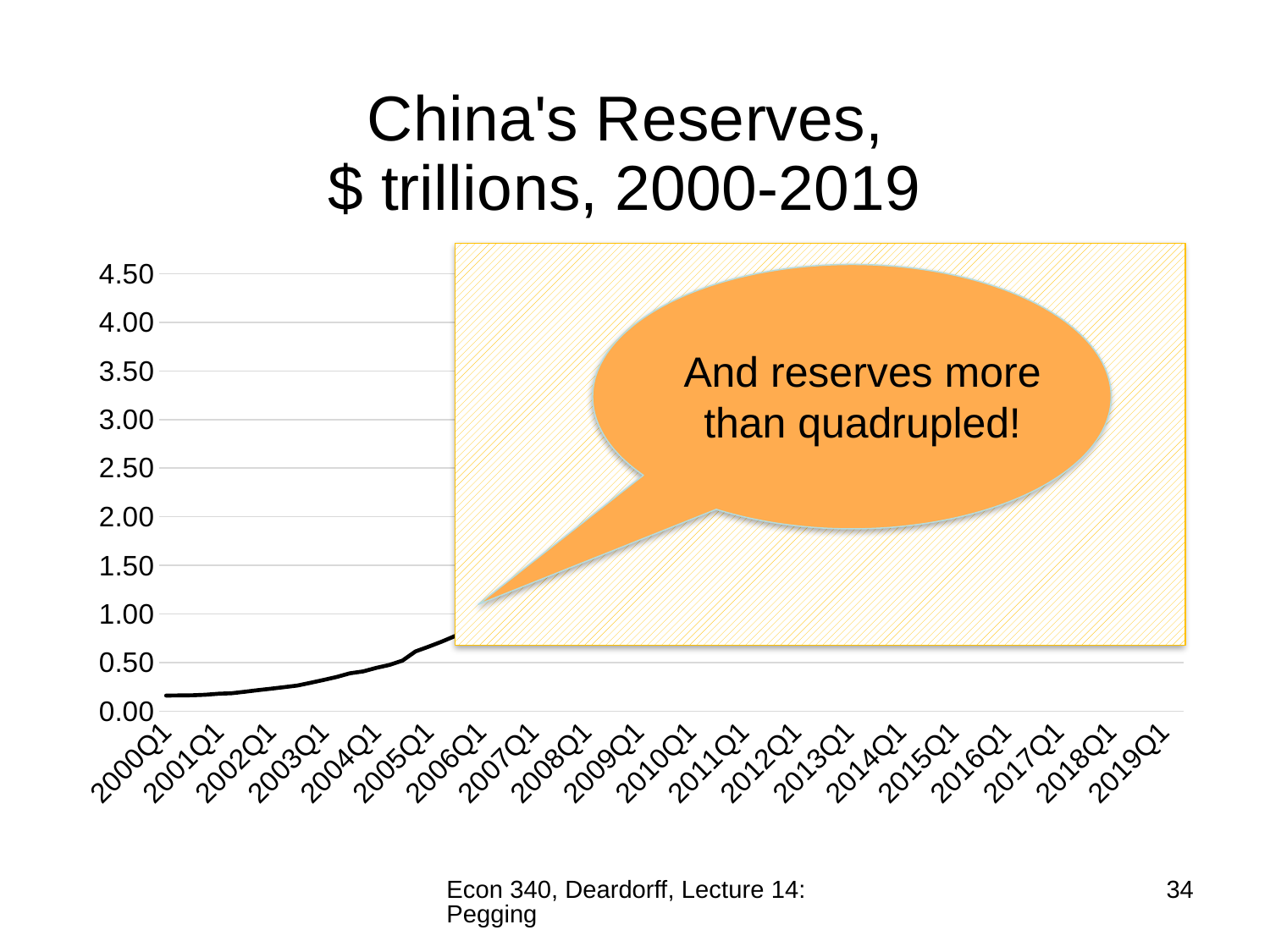
Is the value for 2003Q1 greater or less than 1.00? less Is the value for 2000Q1 greater or less than 0.50? less Which is larger, the value for 2000Q1 or the value for 2005Q1? 2005Q1 How many year labels are shown along the x axis? 20 Over the visible portion of the line from 2000Q1 to 2006Q1, do China's reserves rise or fall? rise Is the value for 2005Q1 greater or less than 1.00? less What kind of chart is shown on the slide? line chart What is the title of the chart? China's Reserves, $ trillions, 2000-2019 What is the highest value labelled on the y axis? 4.50